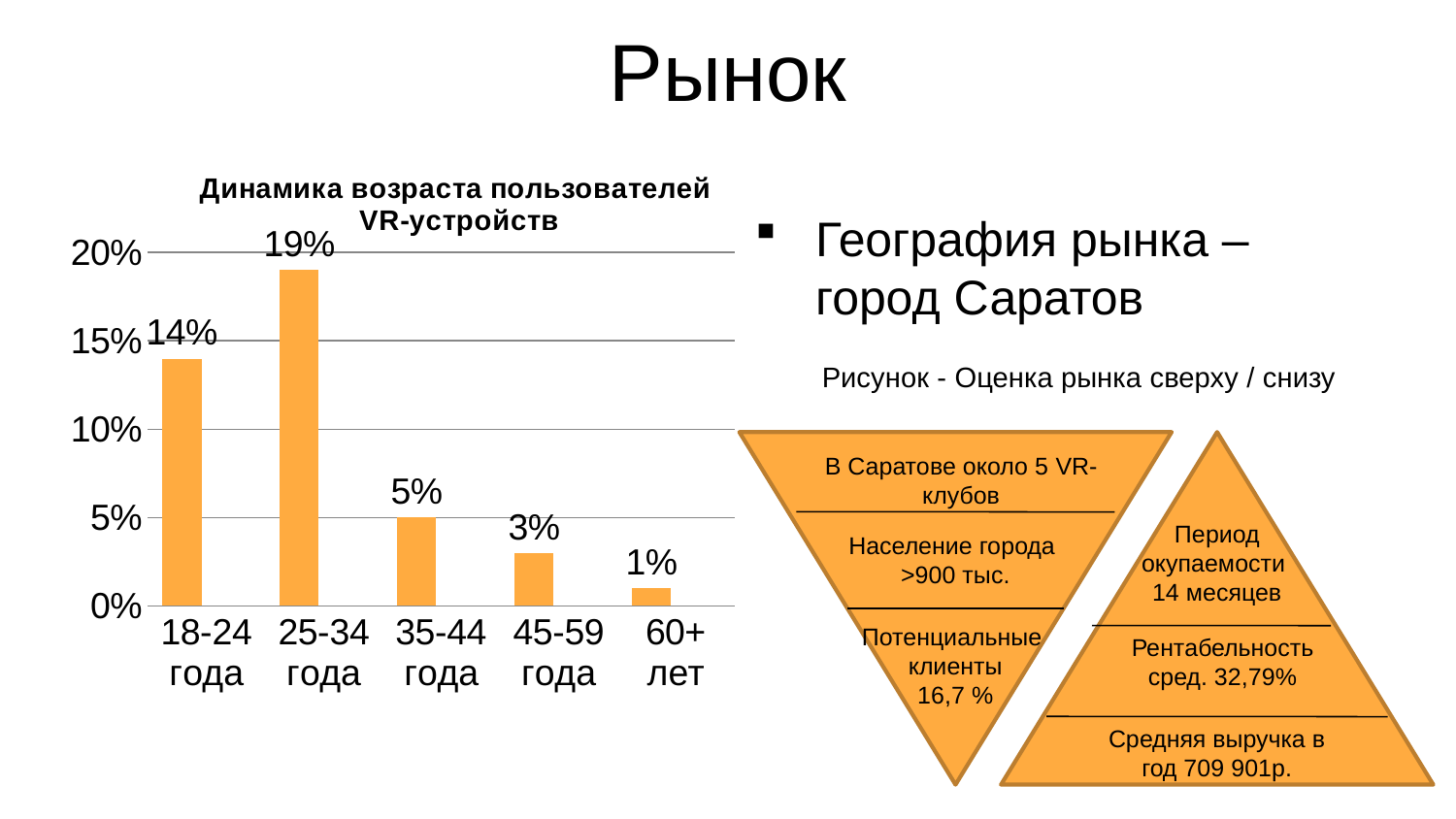
Which is larger, the value for 35-44 года or the value for 45-59 года? 35-44 года What kind of chart is shown on the slide? Bar chart What is the value for the 45-59 года category? 3% What is the difference between the values for 35-44 года and 45-59 года? 2% What is the value for the 18-24 года category? 14% How many age categories are shown on the chart? 5 Which age group has the lowest value? 60+ лет What is the title of the chart? Динамика возраста пользователей VR-устройств What is the difference between the values for 25-34 года and 18-24 года? 5% What is the value for the 25-34 года category? 19% What is the value for the 60+ лет category? 1% Which age group has the highest value? 25-34 года